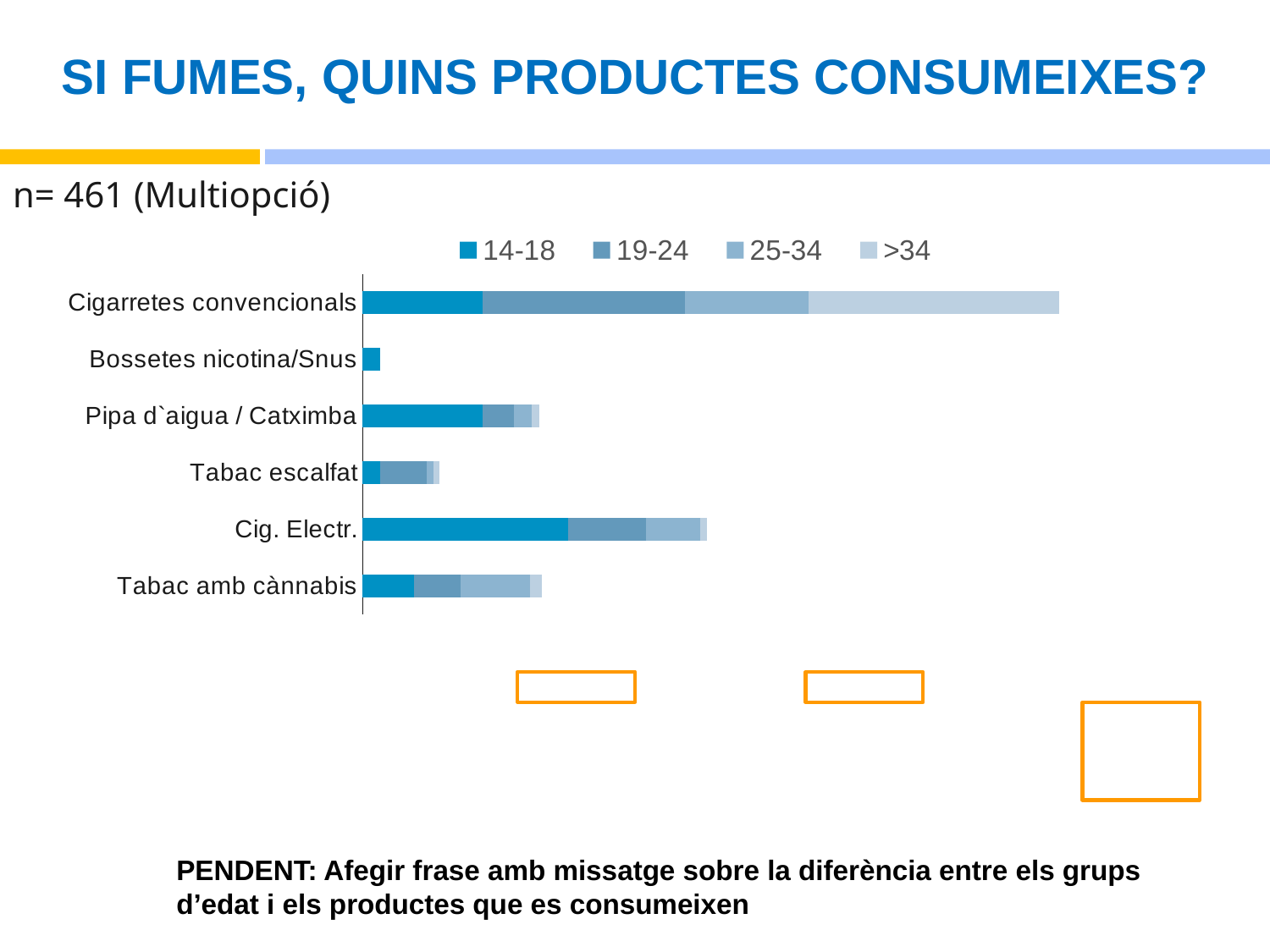
What sample size is stated above the chart? n= 461 (Multiopció) How many product categories are plotted on the chart? 6 What are the four age groups listed in the legend? 14-18, 19-24, 25-34, >34 Which product has the longest total bar? Cigarretes convencionals What kind of chart is shown on the slide? Stacked bar chart Which has the longer total bar, Tabac escalfat or Bossetes nicotina/Snus? Tabac escalfat Which has the longer 14-18 segment, Cig. Electr. or Pipa d`aigua / Catximba? Cig. Electr. Which product has the longest >34 segment? Cigarretes convencionals Which has the longer total bar, Cig. Electr. or Tabac escalfat? Cig. Electr. Which product has the shortest total bar? Bossetes nicotina/Snus How many age-group series does the legend list? 4